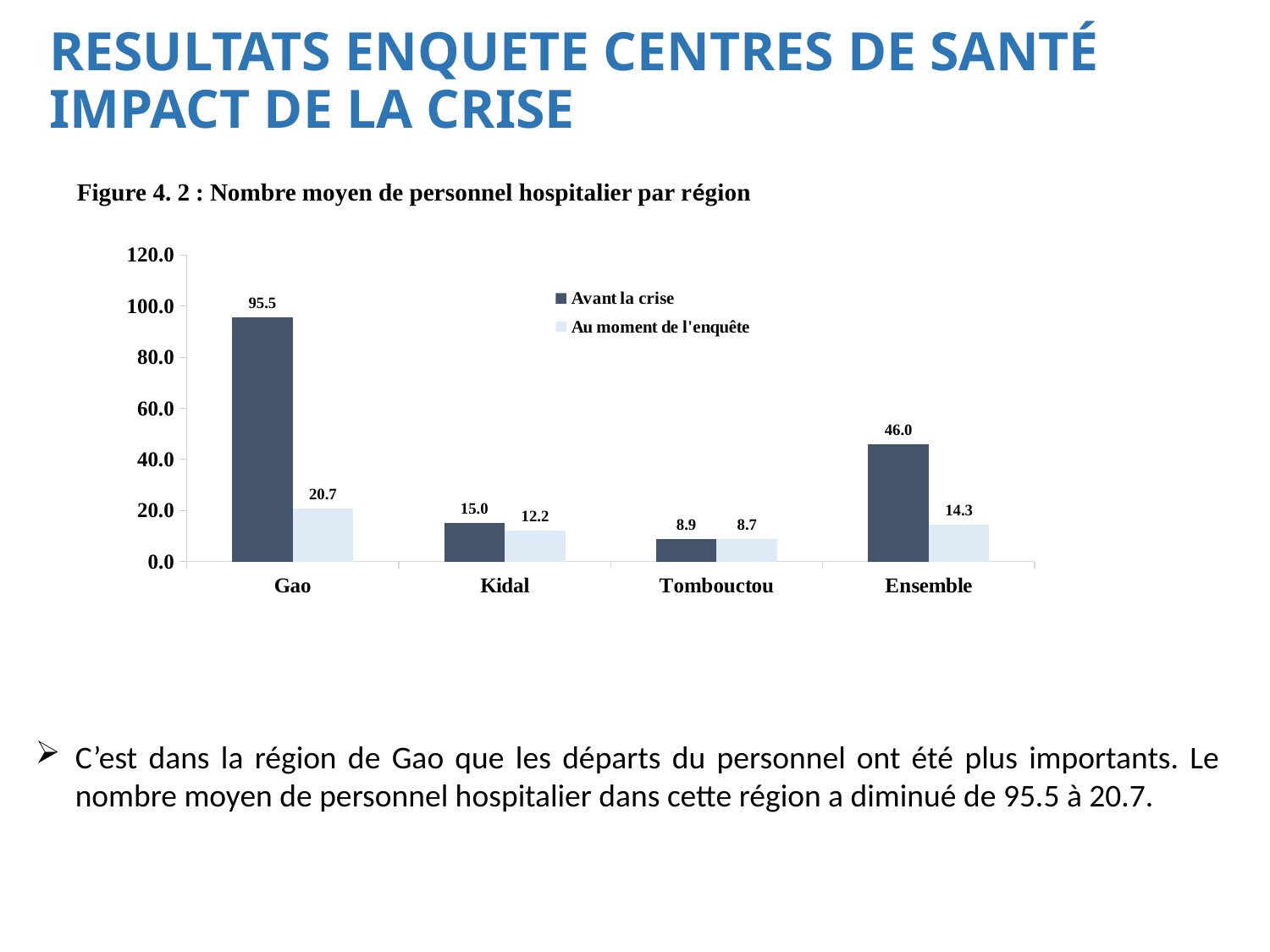
How many categories are shown on the x axis? 4 Which category has the lowest value in the 'Au moment de l'enquête' series? Tombouctou Which is larger for Kidal: the 'Avant la crise' value or the 'Au moment de l'enquête' value? Avant la crise What is the value for Ensemble in the 'Au moment de l'enquête' series? 14.3 What is the value for Tombouctou in the 'Avant la crise' series? 8.9 Is the 'Avant la crise' value for Ensemble greater or less than 40.0? greater How many series does the legend list? 2 What is the value for Gao in the 'Avant la crise' series? 95.5 What is the difference between the 'Avant la crise' and 'Au moment de l'enquête' values for Gao? 74.8 What is the value for Gao in the 'Au moment de l'enquête' series? 20.7 Which region has the highest value in the 'Avant la crise' series? Gao What kind of chart is shown on the slide? Bar chart